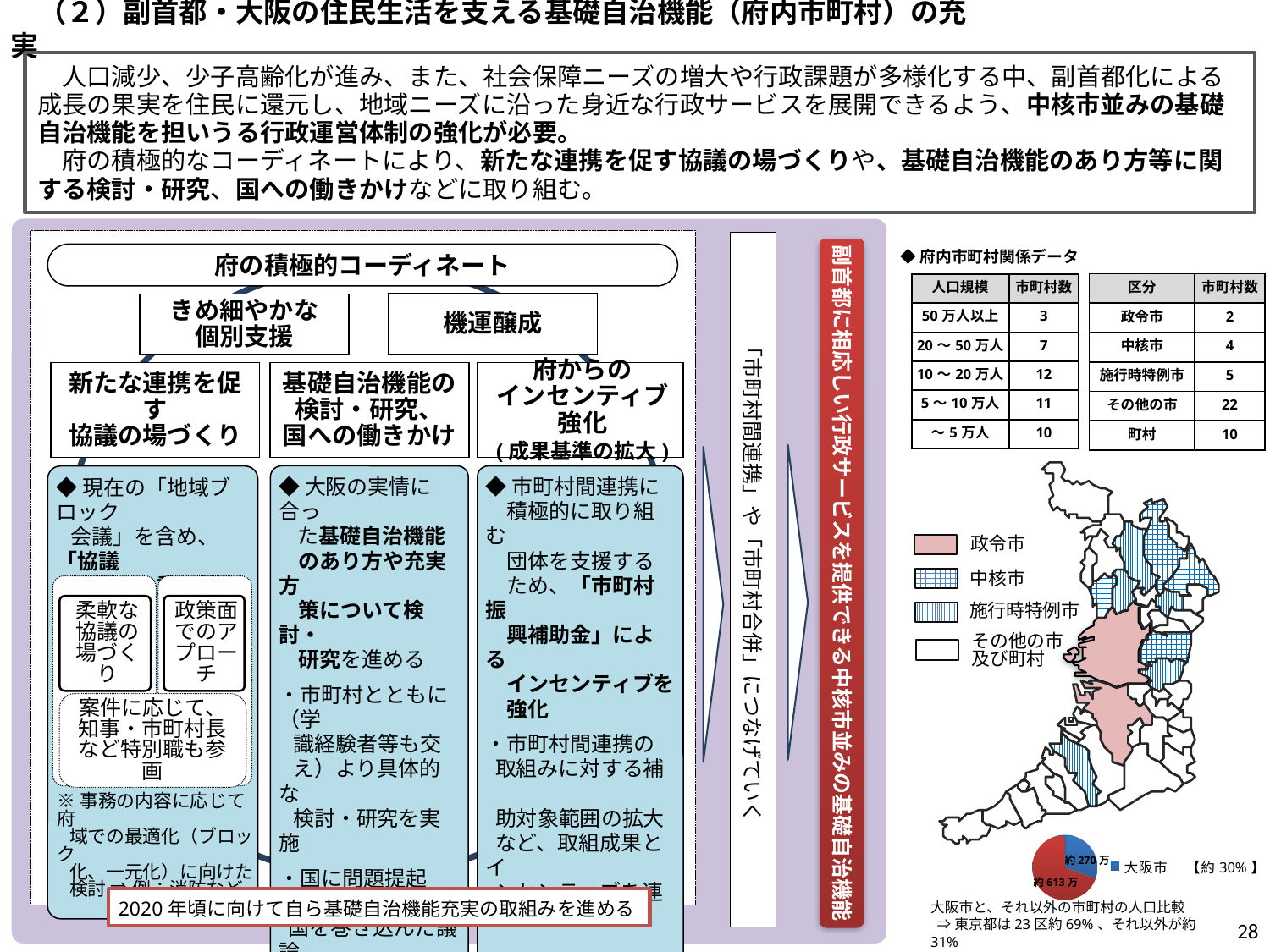
In the pie chart at the bottom right, what value is labelled on the blue slice for 大阪市? 約270万 According to the label next to the pie chart at the bottom right, roughly what share of the population does 大阪市 account for? 約30% What is the caption/title written under the pie chart at the bottom right of the slide? 大阪市と、それ以外の市町村の人口比較 In the pie chart at the bottom right, which slice is the smallest? 大阪市 In the pie chart at the bottom right, which slice is larger: the 大阪市 slice or the slice for the other municipalities? the other municipalities (約613万) What kind of chart is shown at the bottom right of the slide, below the map? pie chart Which category name appears in the legend of the pie chart at the bottom right? 大阪市 In the pie chart at the bottom right, what value is labelled on the red slice (the municipalities other than 大阪市)? 約613万 How many slices does the pie chart at the bottom right of the slide have? 2